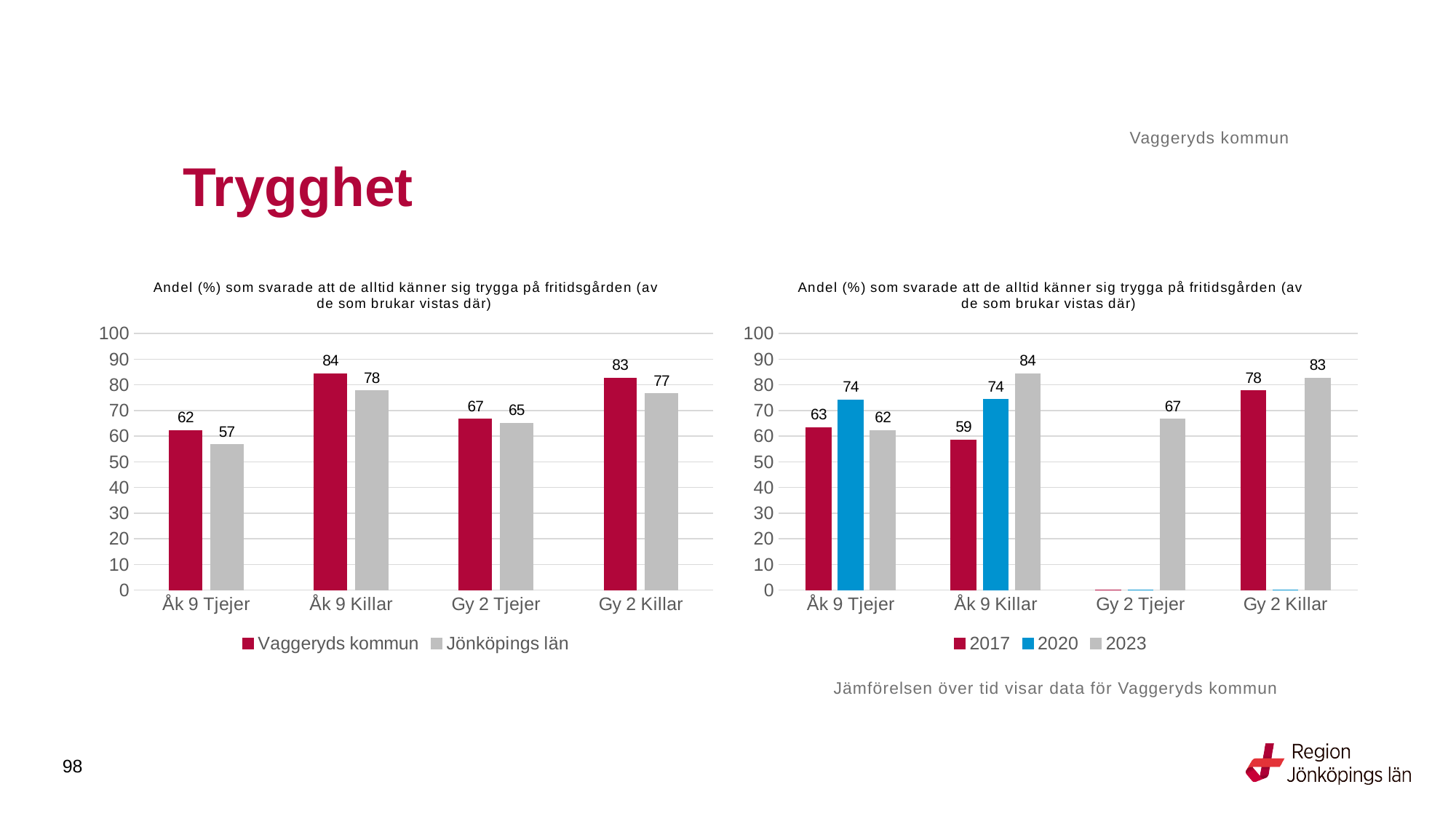
In the left chart, what is the difference between Vaggeryds kommun and Jönköpings län for Gy 2 Killar? 6 In the left chart, which is larger for Gy 2 Tjejer: Vaggeryds kommun or Jönköpings län? Vaggeryds kommun In the right chart, what is the value for 2020 for Åk 9 Tjejer? 74 In the right chart, what is the value for 2017 for Gy 2 Killar? 78 How many series does the legend of the left chart list? 2 How many series does the legend of the right chart list? 3 In the left chart, which category has the lowest value for Jönköpings län? Åk 9 Tjejer In the left chart, what is the value for Vaggeryds kommun for Åk 9 Killar? 84 In the right chart, which category has the highest value for 2023? Åk 9 Killar In the right chart, what is the difference between 2023 and 2017 for Åk 9 Killar? 25 What type of chart is the right chart? Bar chart In the left chart, what is the value for Jönköpings län for Åk 9 Tjejer? 57